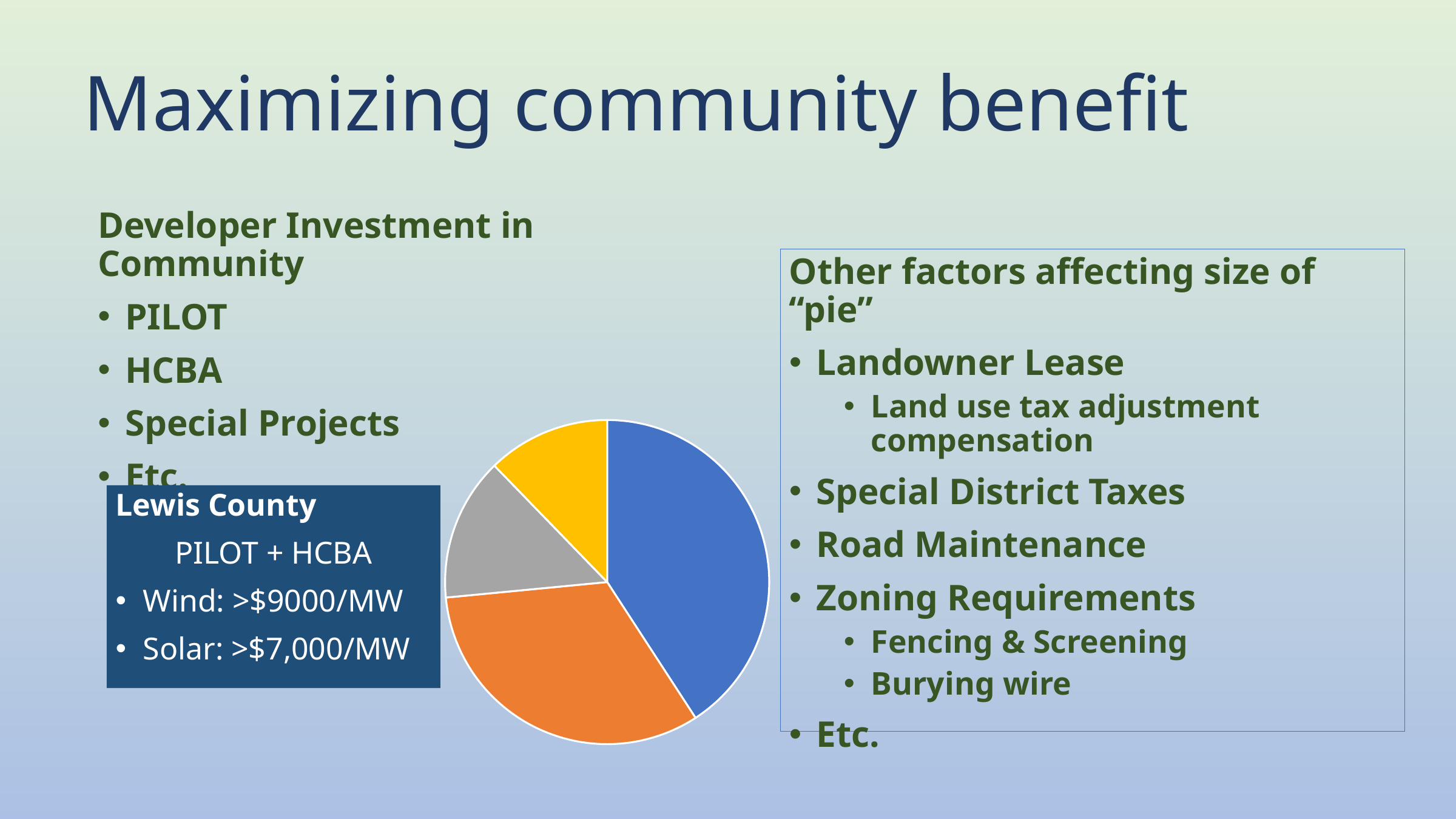
In the pie chart, is the orange slice or the gray slice larger? orange How many slices does the pie chart have? 4 Which colour slice is the largest in the pie chart? blue What kind of chart is shown on the slide? pie chart Does the pie chart have a legend? No Does the pie chart show data labels on its slices? No In the pie chart, is the blue slice or the orange slice larger? blue In the pie chart, is the blue slice or the yellow slice larger? blue